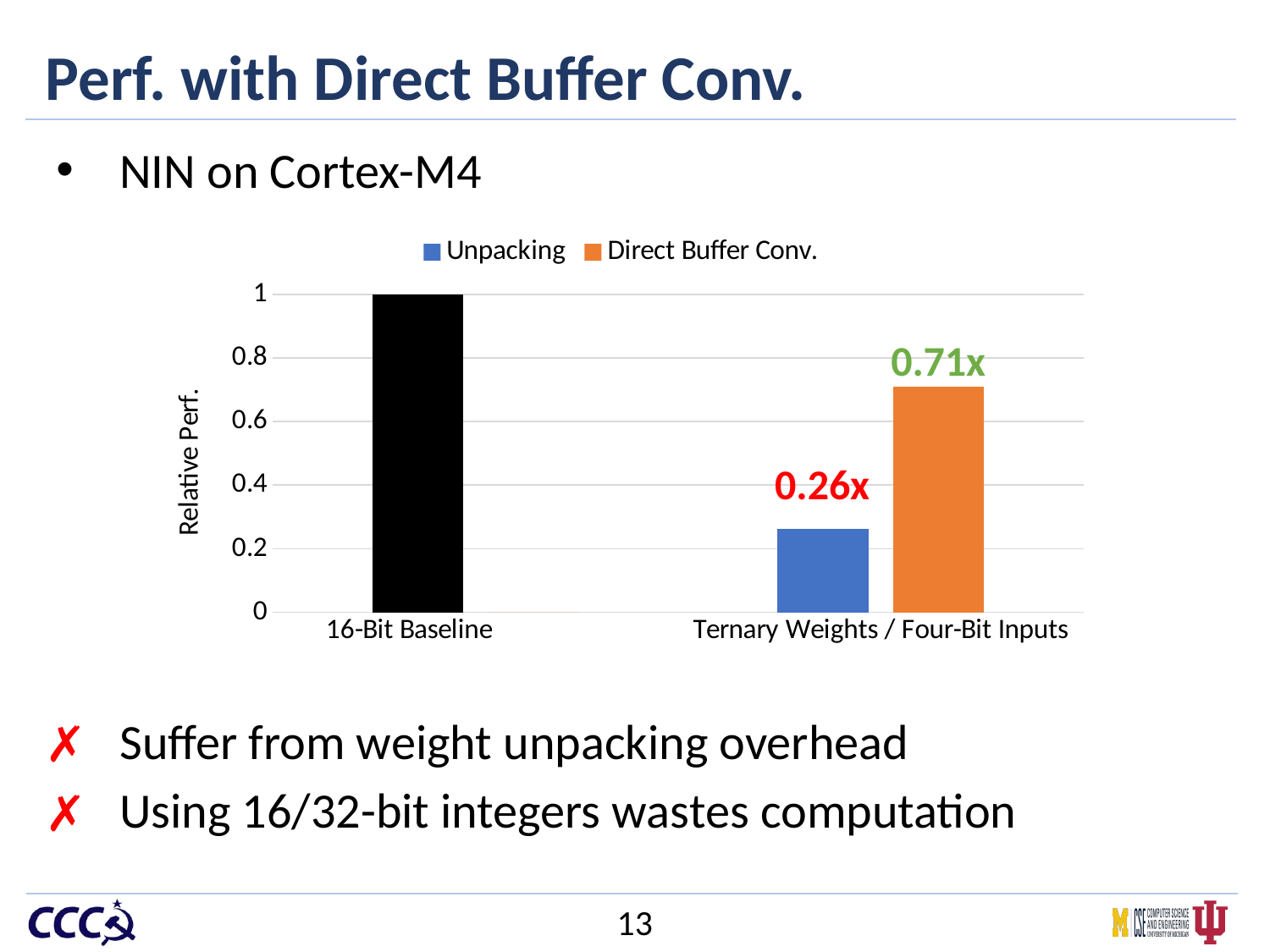
Is the Direct Buffer Conv. value for Ternary Weights / Four-Bit Inputs greater or less than 0.6? greater What is the label of the y axis of the chart? Relative Perf. How many series does the chart legend list? 2 What kind of chart is shown on the slide? bar chart What is the relative performance of the 16-Bit Baseline bar? 1 What is the data label on the Unpacking bar for Ternary Weights / Four-Bit Inputs? 0.26x How many categories are shown on the x axis of the chart? 2 Which bar in the chart is the highest? 16-Bit Baseline What is the data label on the Direct Buffer Conv. bar for Ternary Weights / Four-Bit Inputs? 0.71x Which bar in the chart is the lowest? Unpacking (Ternary Weights / Four-Bit Inputs) Which series has the higher value for Ternary Weights / Four-Bit Inputs, Unpacking or Direct Buffer Conv.? Direct Buffer Conv. What are the two series named in the chart legend? Unpacking and Direct Buffer Conv.